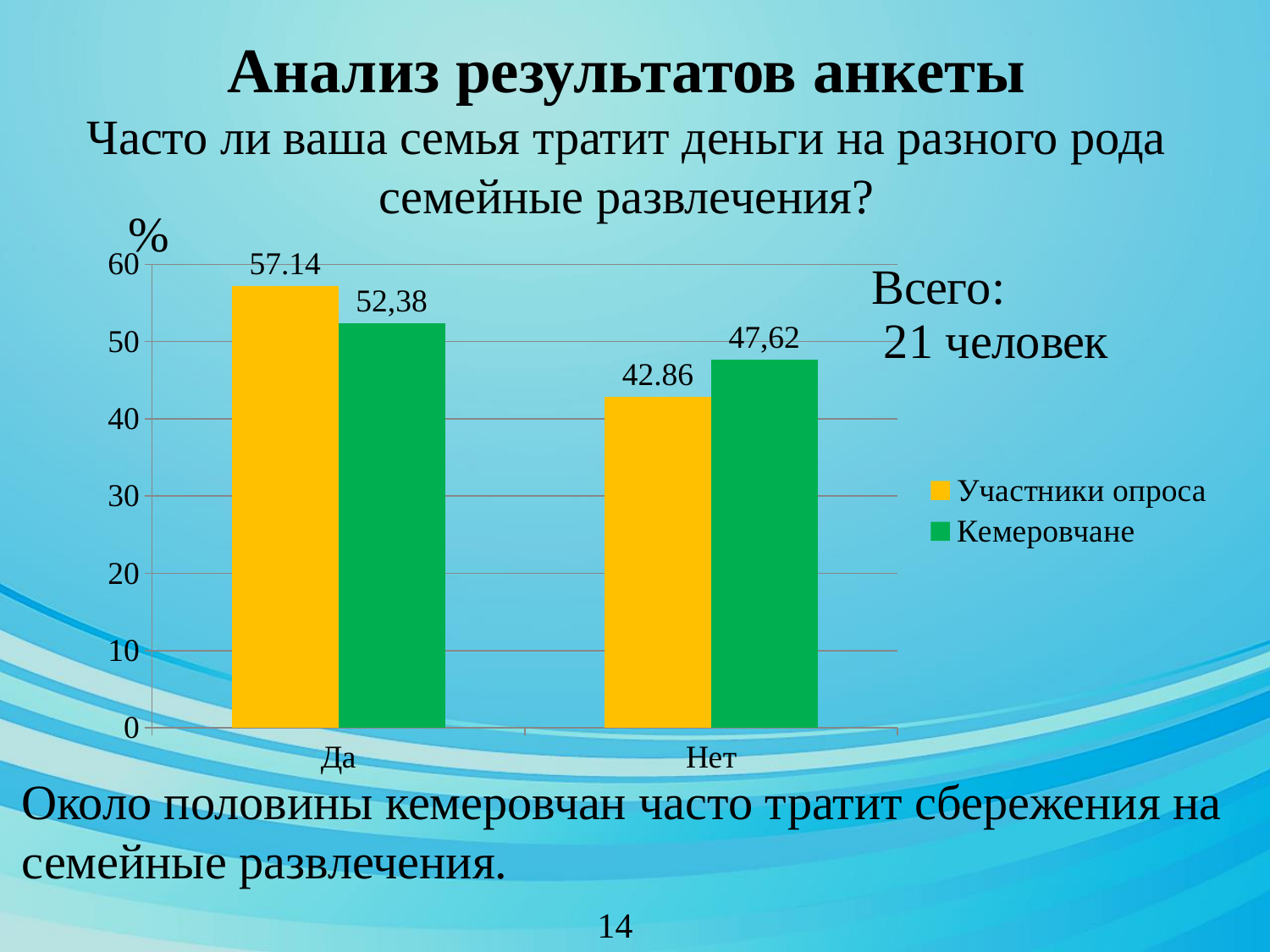
Is the value for Участники опроса in the Да category greater or less than 50? greater What kind of chart is shown on the slide? bar chart In the Нет category, which series has the larger value: Участники опроса or Кемеровчане? Кемеровчане What is the difference between the Участники опроса values for Да and Нет? 14.28 What is the value for Кемеровчане in the Нет category? 47,62 Which category has the lowest value for Кемеровчане? Нет How many series does the legend list? 2 What is the value for Кемеровчане in the Да category? 52,38 What is the value for Участники опроса in the Нет category? 42.86 What is the value for Участники опроса in the Да category? 57.14 How many categories are shown on the x axis? 2 Which category has the highest value for Участники опроса? Да